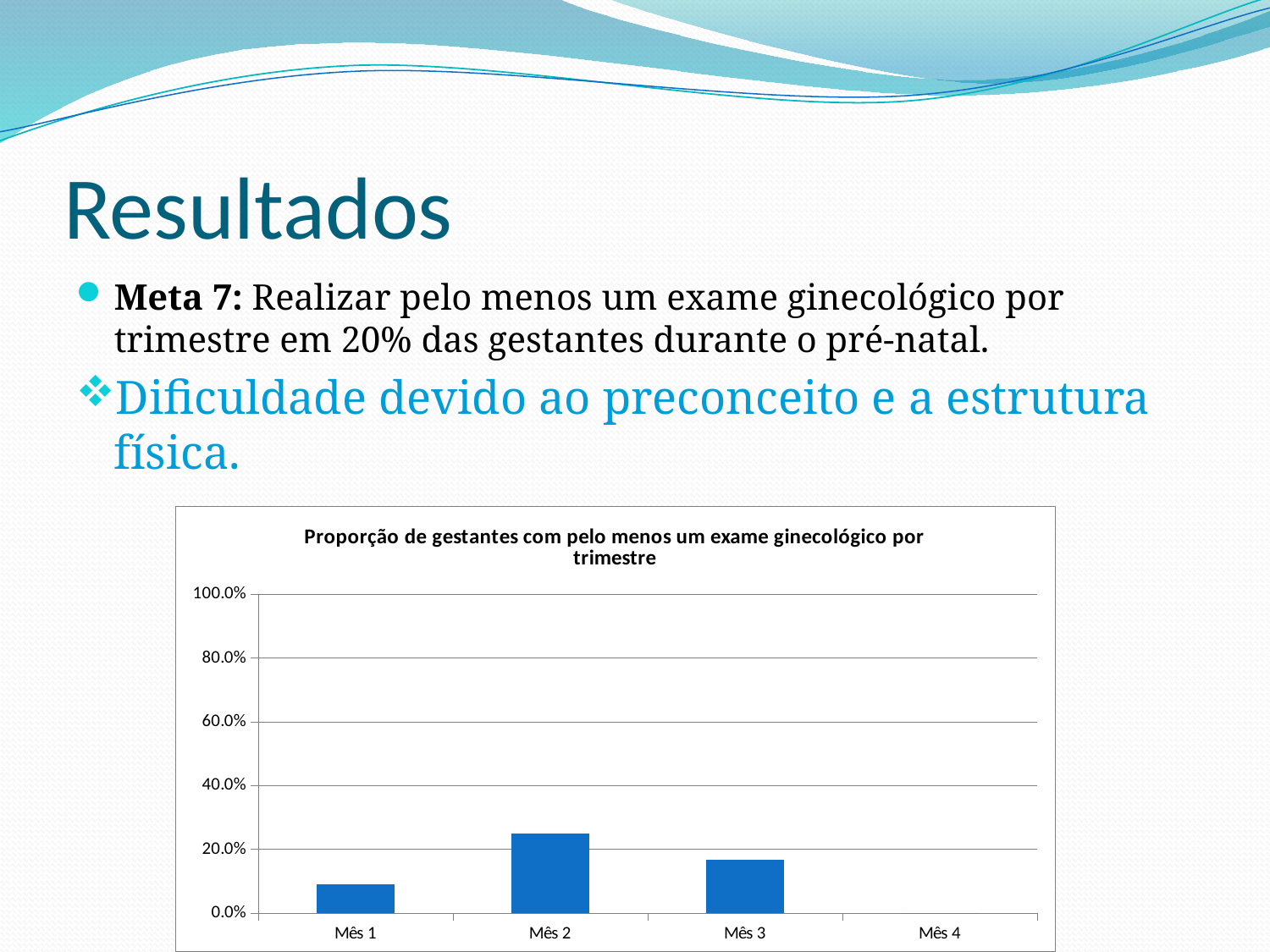
Which month has the highest proportion in the chart? Mês 2 What is the highest value labelled on the y axis of the chart? 100.0% Is the value for Mês 2 greater or less than 20.0%? greater Which is larger, the value for Mês 1 or the value for Mês 3? Mês 3 What kind of chart is shown on the slide? bar chart Is the value for Mês 2 greater or less than 40.0%? less Which is larger, the value for Mês 2 or the value for Mês 3? Mês 2 Which month has no visible bar in the chart? Mês 4 Is the value for Mês 3 greater or less than 20.0%? less What is the title of the chart? Proporção de gestantes com pelo menos um exame ginecológico por trimestre How many categories (months) are shown on the x axis of the chart? 4